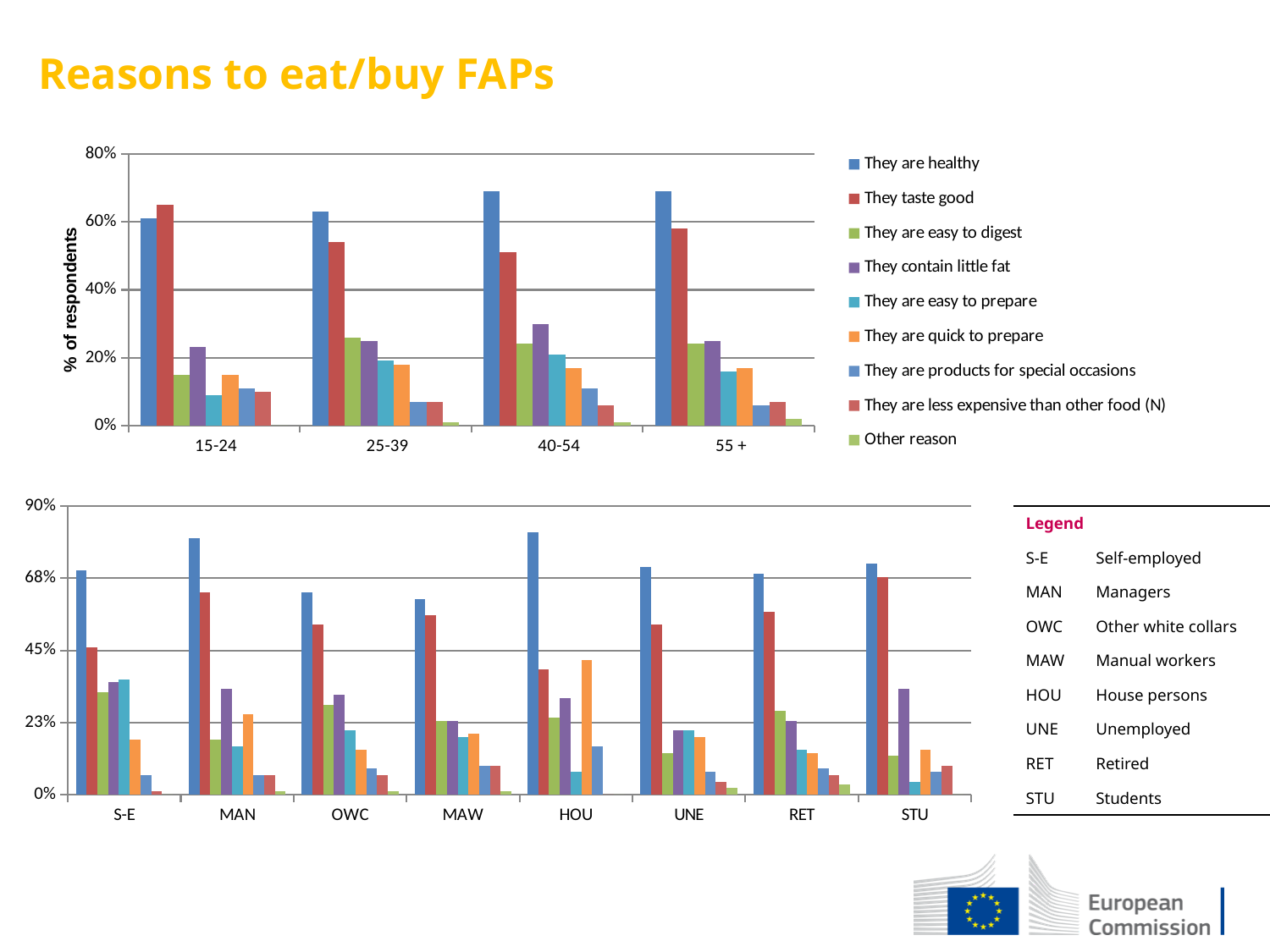
In the top chart, is the value of 'They taste good' for the 15-24 group greater or less than 60%? greater In the bottom chart, which occupation has the highest value for 'They are quick to prepare'? HOU In the top chart, which reason has the highest value for the 15-24 group? They taste good How many occupation categories are shown on the x axis of the bottom chart? 8 What is the y-axis title of the top chart? % of respondents In the top chart, which reason has the lowest value for the 25-39 group? Other reason How many age groups are shown on the x axis of the top chart? 4 In the bottom chart, is the value of 'They are healthy' for MAW greater or less than 68%? less In the top chart, is the value of 'They are healthy' for the 15-24 group greater or less than 40%? greater How many series does the legend of the top chart list? 9 In the top chart, for the 40-54 group, which is larger: 'They are healthy' or 'They taste good'? They are healthy What kind of chart is the top chart on the slide? Bar chart